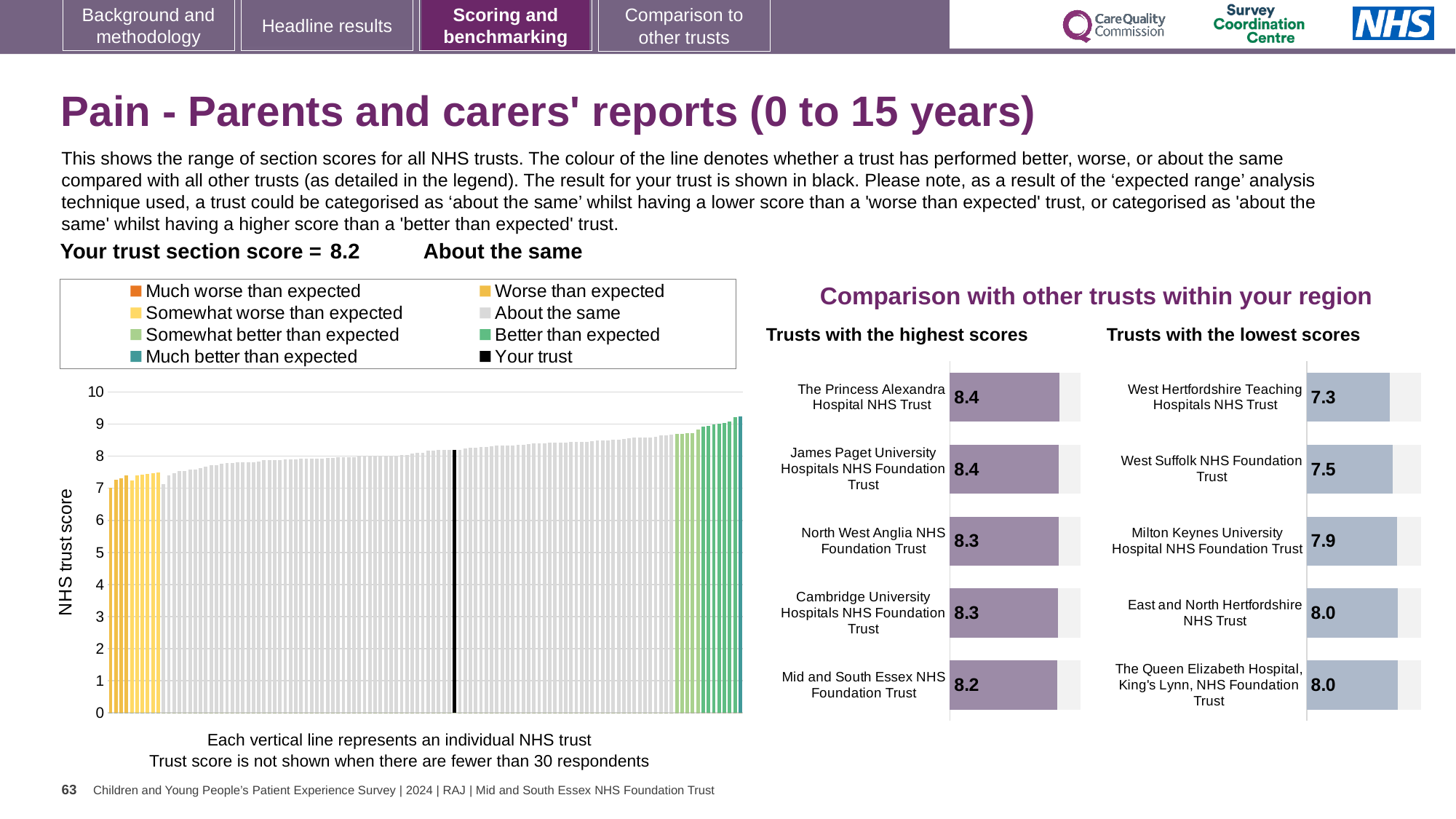
In the large NHS trust score chart, is the value of the black bar (your trust) greater or less than 5? greater In the 'Trusts with the lowest scores' chart, which has the higher score: Milton Keynes University Hospital NHS Foundation Trust or West Suffolk NHS Foundation Trust? Milton Keynes University Hospital NHS Foundation Trust In the 'Trusts with the highest scores' chart, what is the score for North West Anglia NHS Foundation Trust? 8.3 What kind of chart is the large chart on the left showing NHS trust scores? Bar chart How many entries does the legend of the large NHS trust score chart list? 8 In the large NHS trust score chart, do the bar values rise or fall from left to right along the x axis? Rise In the 'Trusts with the lowest scores' chart, what is the difference between the scores of West Suffolk NHS Foundation Trust and West Hertfordshire Teaching Hospitals NHS Trust? 0.2 In the 'Trusts with the highest scores' chart, which trust has the lowest score shown? Mid and South Essex NHS Foundation Trust In the 'Trusts with the lowest scores' chart, what is the score for West Hertfordshire Teaching Hospitals NHS Trust? 7.3 How many trusts are shown in the 'Trusts with the highest scores' chart? 5 In the 'Trusts with the highest scores' chart, what is the score for Mid and South Essex NHS Foundation Trust? 8.2 In the 'Trusts with the lowest scores' chart, which trust has the lowest score? West Hertfordshire Teaching Hospitals NHS Trust